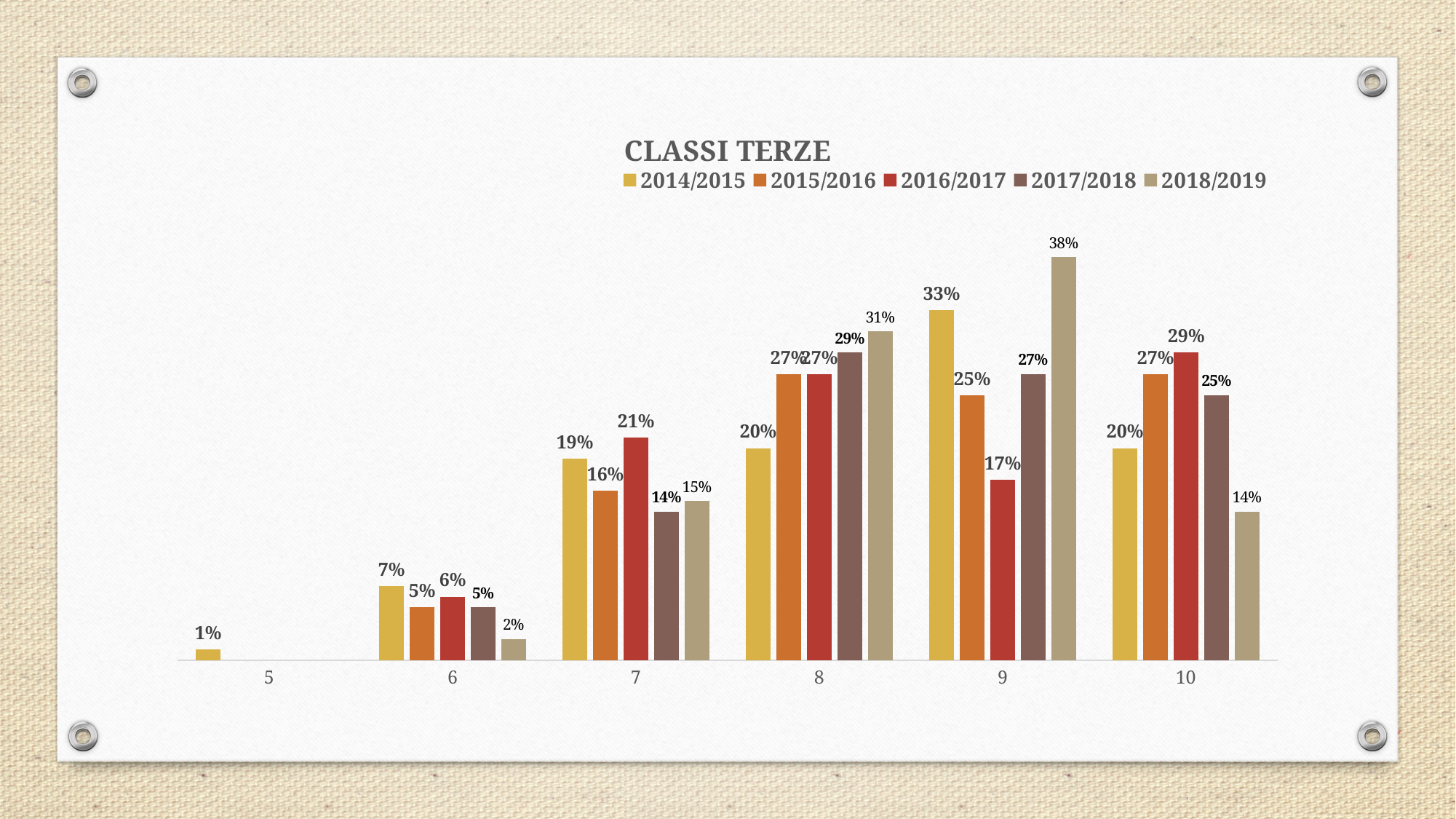
What is the difference between the 2018/2019 value and the 2014/2015 value at category 9? 5% What is the value for 2016/2017 at category 7? 21% What kind of chart is shown on the slide? bar chart At category 10, which series has the larger value: 2016/2017 or 2018/2019? 2016/2017 Which series is shown in the last (rightmost) legend entry? 2018/2019 Which category has the highest value for the 2014/2015 series? 9 How many categories are shown on the x axis? 6 Which category has the lowest value for the 2018/2019 series? 6 What is the value for 2018/2019 at category 9? 38% What is the value for 2014/2015 at category 5? 1% How many series does the legend list? 5 What is the title of the chart? CLASSI TERZE